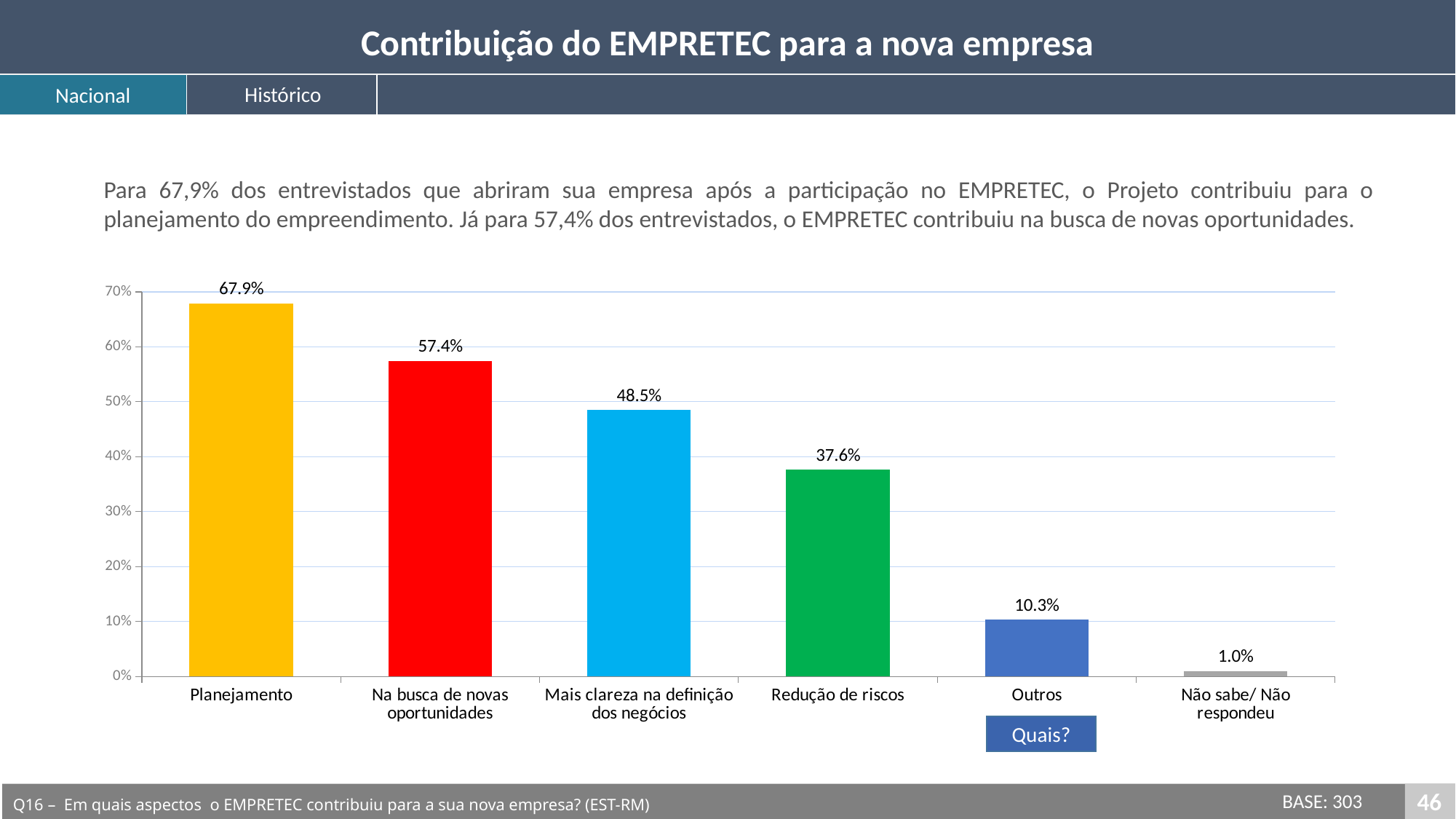
What is the difference between the values for Planejamento and Na busca de novas oportunidades? 10.5% Do the values rise or fall from left to right along the x axis? fall What is the value for Não sabe/ Não respondeu? 1.0% What is the value for Redução de riscos? 37.6% What kind of chart is shown on the slide? bar chart Which category has the lowest value? Não sabe/ Não respondeu Which is larger, the value for Mais clareza na definição dos negócios or the value for Redução de riscos? Mais clareza na definição dos negócios Is the value for Outros greater or less than 20%? less Which category has the highest value? Planejamento How many categories are shown on the x axis? 6 What is the value for Planejamento? 67.9% What colour is the bar for Redução de riscos? green